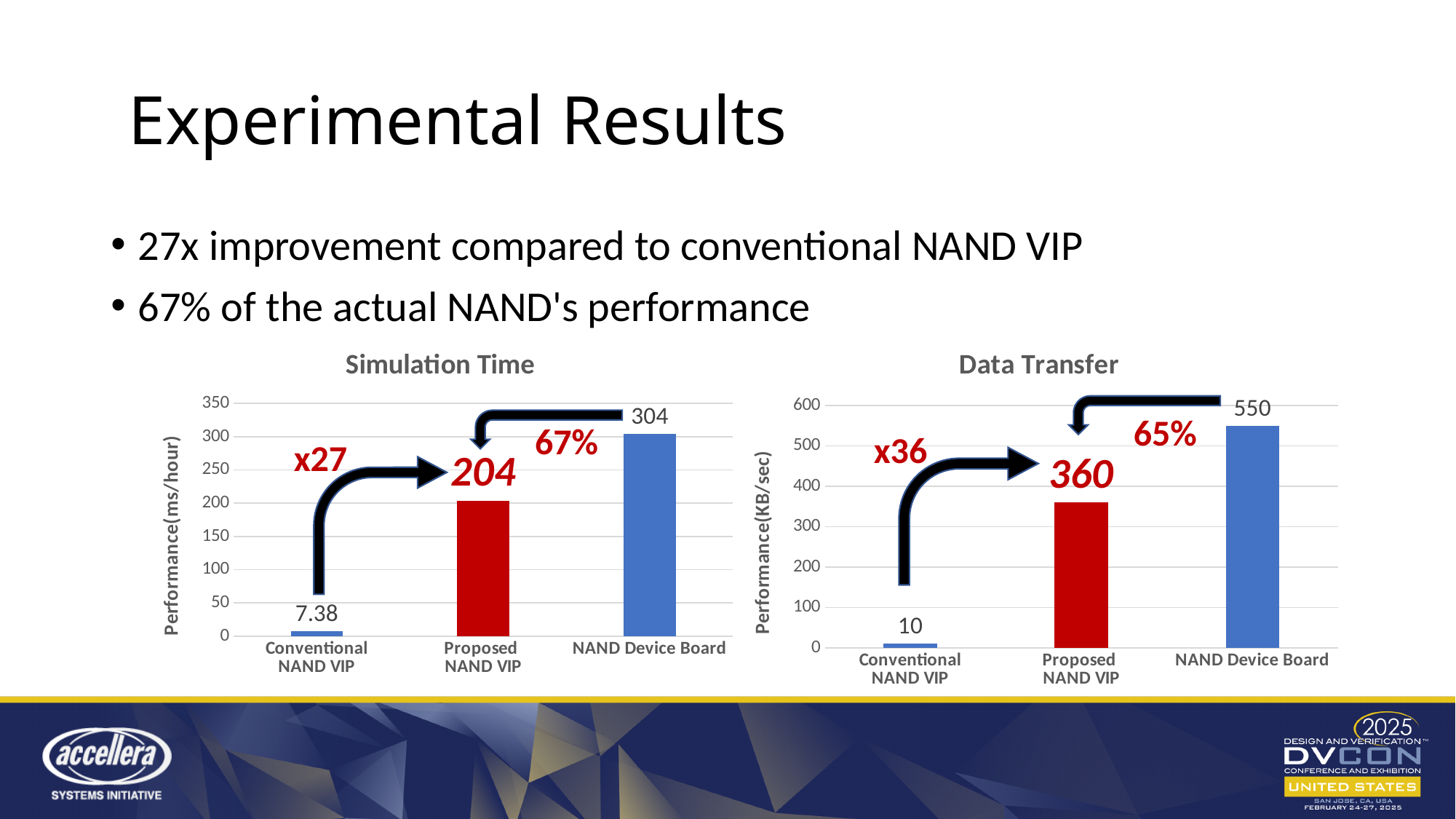
In the Simulation Time chart, what is the value for NAND Device Board? 304 In the Data Transfer chart, what is the value for NAND Device Board? 550 In the Simulation Time chart, what is the value for Proposed NAND VIP? 204 In the Data Transfer chart, which category has the lowest value? Conventional NAND VIP In the Simulation Time chart, which category has the highest value? NAND Device Board In the Data Transfer chart, is the value for Proposed NAND VIP larger or smaller than the value for NAND Device Board? smaller How many categories are shown in the Simulation Time chart? 3 In the Simulation Time chart, what is the value for Conventional NAND VIP? 7.38 In the Data Transfer chart, what is the difference between NAND Device Board and Proposed NAND VIP? 190 In the Simulation Time chart, what is the difference between NAND Device Board and Proposed NAND VIP? 100 In the Data Transfer chart, what is the value for Proposed NAND VIP? 360 What type of chart is the Data Transfer chart? bar chart